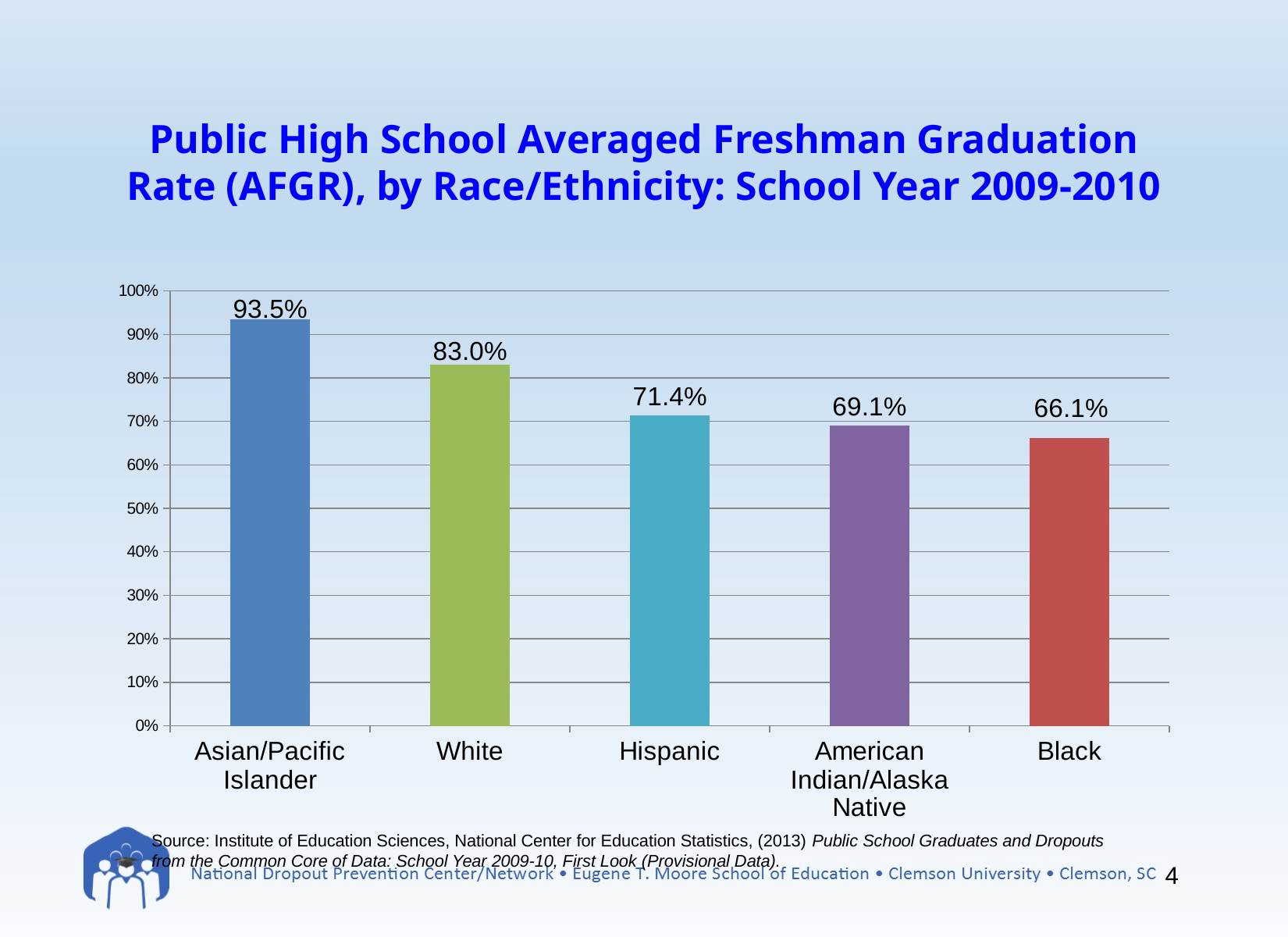
How many race/ethnicity categories are shown in the chart? 5 Which race/ethnicity has the lowest graduation rate? Black What is the graduation rate for Hispanic students? 71.4% Is the graduation rate for White students greater or less than 80%? greater Do the graduation rates rise or fall from left to right across the categories? Fall What is the graduation rate for Asian/Pacific Islander students? 93.5% What is the graduation rate for American Indian/Alaska Native students? 69.1% What kind of chart is shown on the slide? Bar chart Which has a higher graduation rate, Hispanic or American Indian/Alaska Native? Hispanic Which race/ethnicity has the highest graduation rate? Asian/Pacific Islander What is the difference between the graduation rates for Asian/Pacific Islander and Hispanic students? 22.1% What is the difference between the graduation rates for White and Black students? 16.9%